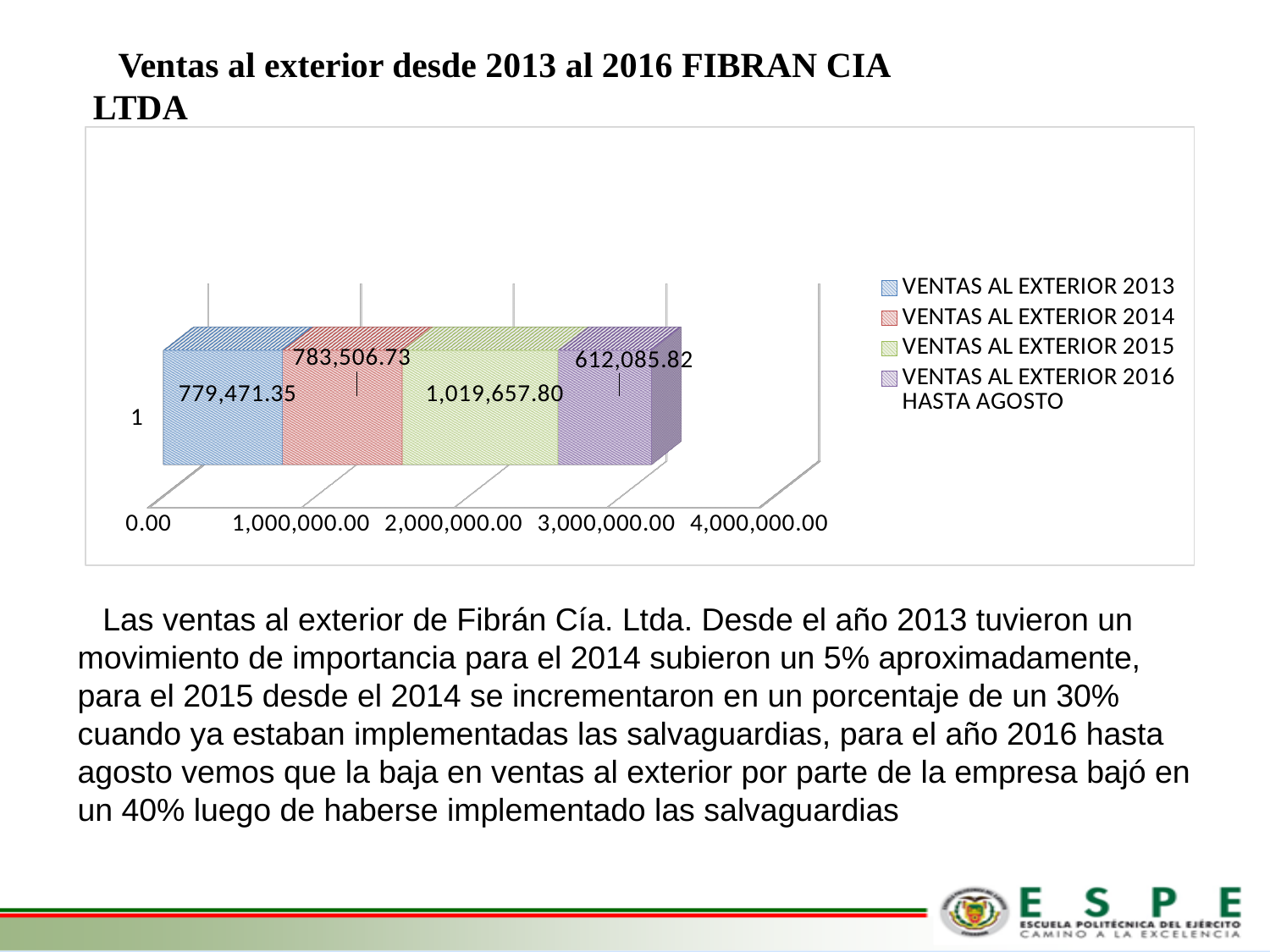
What is the value for VENTAS AL EXTERIOR 2015? 1,019,657.80 What type of chart is shown on the slide? bar chart What is the difference between the values for VENTAS AL EXTERIOR 2015 and VENTAS AL EXTERIOR 2014? 236,151.07 Which series has the highest value? VENTAS AL EXTERIOR 2015 What is the value for VENTAS AL EXTERIOR 2014? 783,506.73 Is the total of the stacked bar greater or less than 4,000,000.00? less What is the value for VENTAS AL EXTERIOR 2013? 779,471.35 Which series has the lowest value? VENTAS AL EXTERIOR 2016 HASTA AGOSTO What is the total of the stacked bar? 3,194,721.70 Which is larger, the value for VENTAS AL EXTERIOR 2015 or VENTAS AL EXTERIOR 2016 HASTA AGOSTO? VENTAS AL EXTERIOR 2015 How many series does the legend list? 4 What is the value for VENTAS AL EXTERIOR 2016 HASTA AGOSTO? 612,085.82